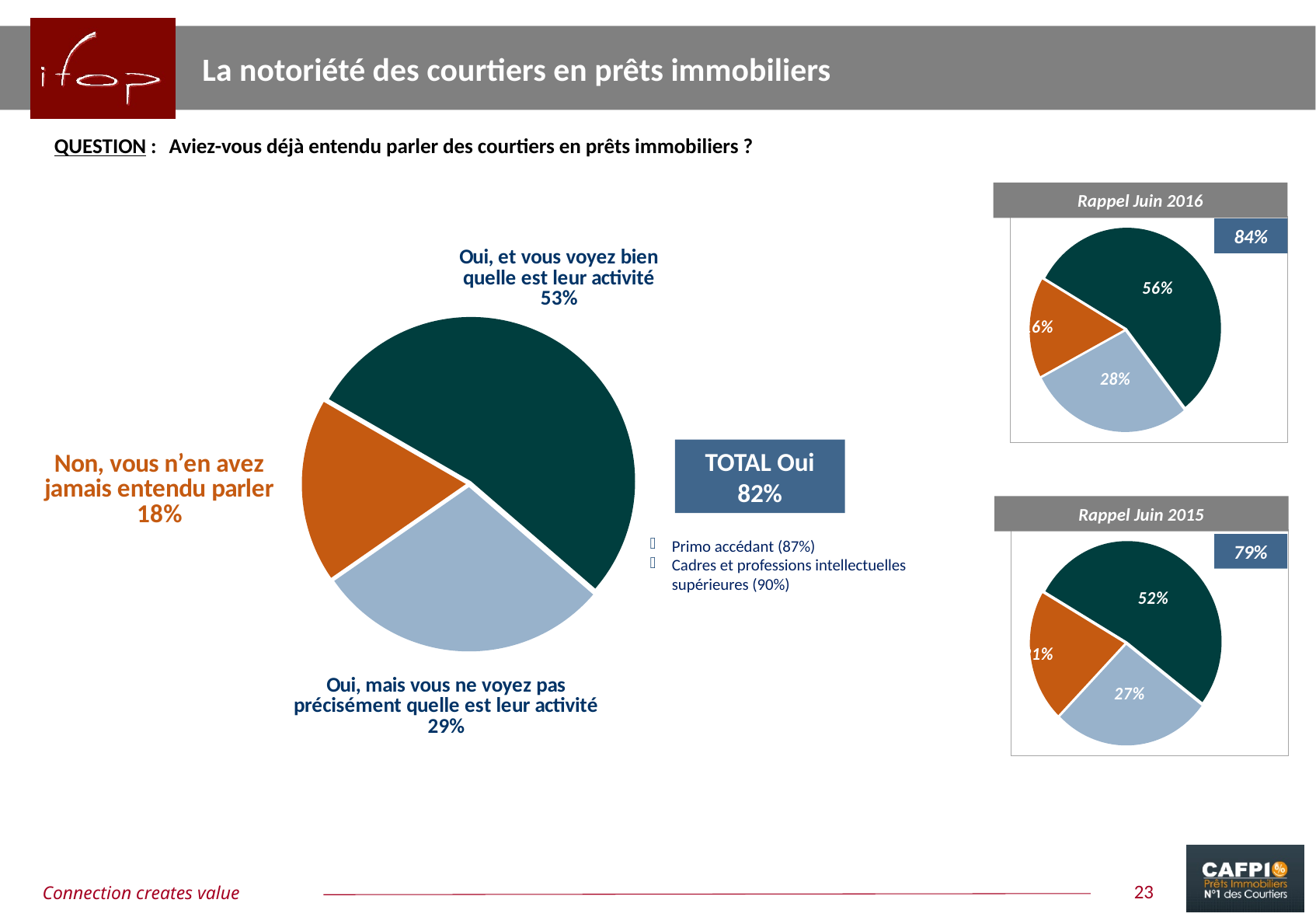
In the main pie chart, what share of respondents answered "Oui, mais vous ne voyez pas précisément quelle est leur activité"? 29% Which is larger: the total "Oui" in "Rappel Juin 2016" or in "Rappel Juin 2015"? Rappel Juin 2016 (84%) In the main pie chart, what share of respondents answered "Oui, et vous voyez bien quelle est leur activité"? 53% What type of chart is used on this slide? Pie chart In the main pie chart, what is the difference in percentage points between "Oui, et vous voyez bien quelle est leur activité" and "Oui, mais vous ne voyez pas précisément quelle est leur activité"? 24 percentage points In the "Rappel Juin 2015" pie chart, what is the value of the light blue slice? 27% In the "Rappel Juin 2016" pie chart, what is the value of the dark green slice? 56% In the main pie chart, which response has the largest slice? Oui, et vous voyez bien quelle est leur activité In the main pie chart, what share of respondents answered "Non, vous n'en avez jamais entendu parler"? 18% What is the "TOTAL Oui" value shown next to the main pie chart? 82% How many slices does the main pie chart have? 3 In the main pie chart, which response has the smallest slice? Non, vous n'en avez jamais entendu parler